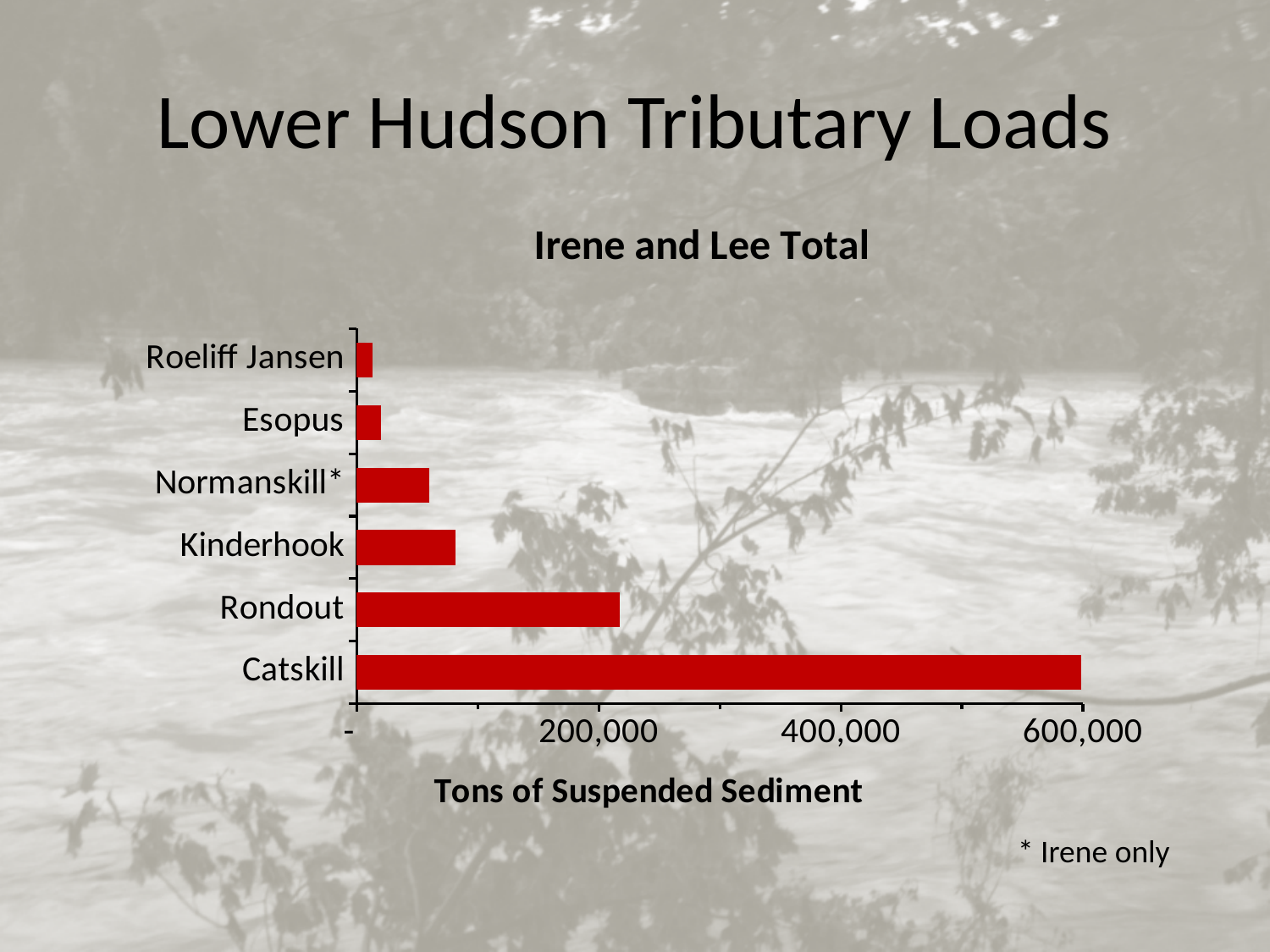
How many tributaries are shown in the chart? 6 What does the asterisk next to Normanskill indicate? Irene only What is the title of the chart? Irene and Lee Total Which tributary has the lowest load of suspended sediment? Roeliff Jansen Is the value for Kinderhook greater or less than 200,000? less Is the value for Esopus greater or less than 200,000? less Which tributary has the highest load of suspended sediment? Catskill What kind of chart is shown on the slide? bar chart Is the value for Rondout greater or less than 200,000? greater Which has a larger load, Rondout or Kinderhook? Rondout Which has a larger load, Normanskill or Esopus? Normanskill